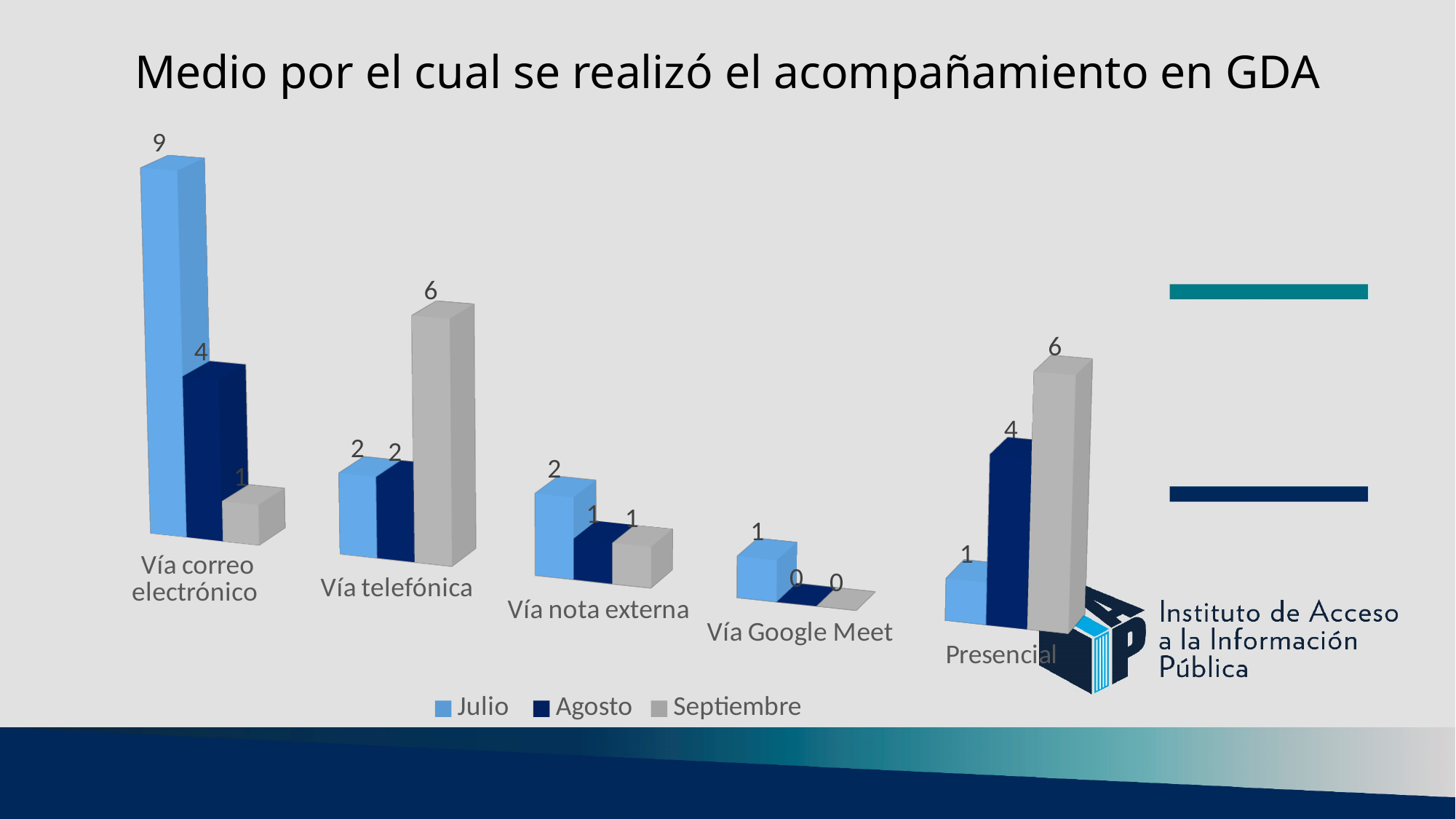
What is the difference between the Julio and Septiembre values for Vía correo electrónico? 8 Which category has the highest Julio value? Vía correo electrónico How many series does the legend list? 3 What is the value for Septiembre in the Vía telefónica category? 6 What is the value for Julio in the Vía correo electrónico category? 9 What is the value for Agosto in the Presencial category? 4 Which category has the lowest Septiembre value? Vía Google Meet What is the title of the chart? Medio por el cual se realizó el acompañamiento en GDA Which is larger for Vía telefónica: the Julio value or the Septiembre value? Septiembre What kind of chart is shown on the slide? Bar chart How many categories are shown on the x axis? 5 What is the value for Agosto in the Vía Google Meet category? 0